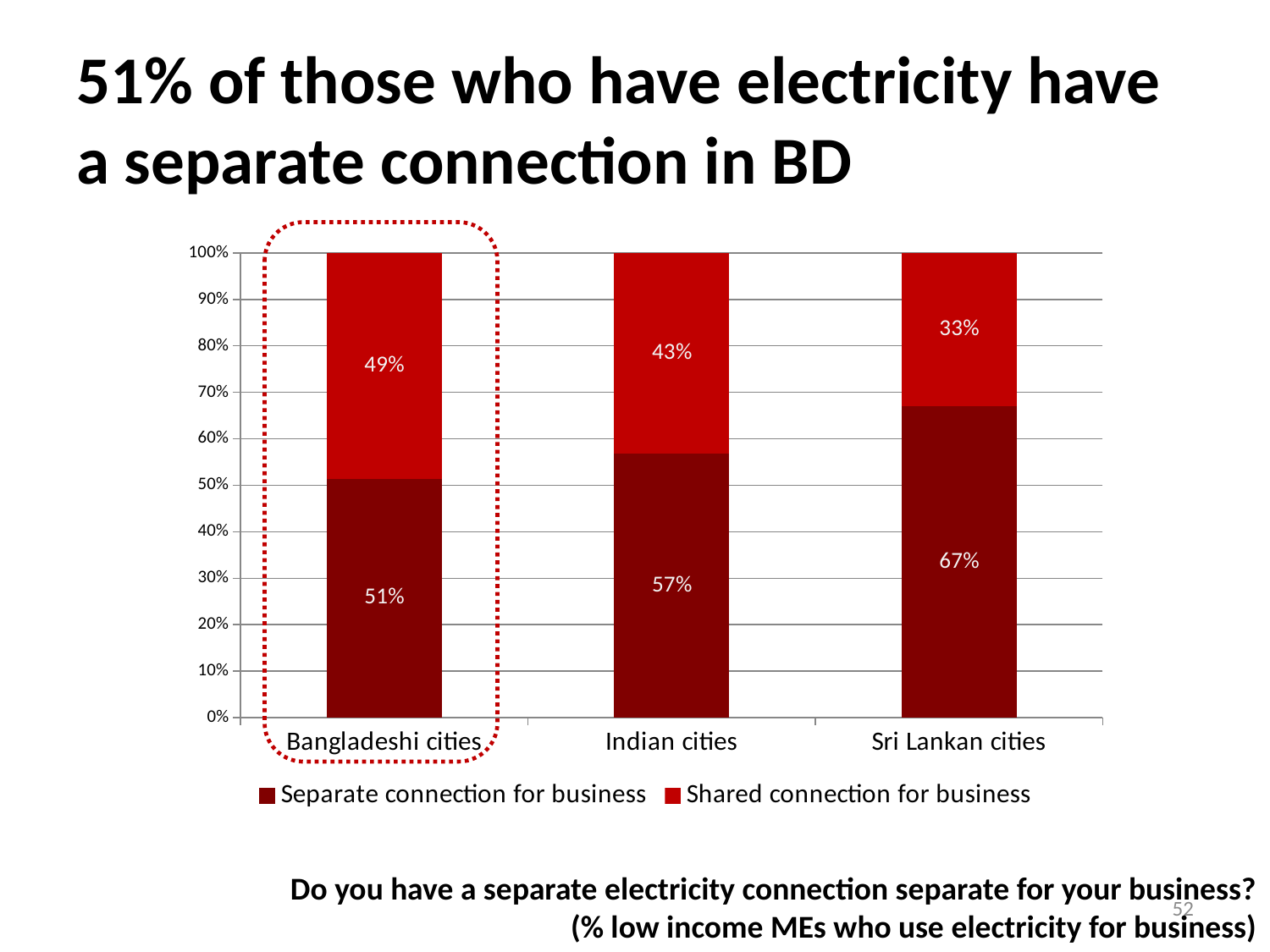
What percentage of low income MEs in Bangladeshi cities have a separate connection for business? 51% Which city group has the lowest share of separate connections for business? Bangladeshi cities What percentage of low income MEs in Indian cities have a shared connection for business? 43% Which series is shown in the darker red colour? Separate connection for business How many city groups are shown on the x axis? 3 What kind of chart is shown on the slide? Stacked bar chart Which city group has the highest share of separate connections for business? Sri Lankan cities What percentage of low income MEs in Sri Lankan cities have a shared connection for business? 33% Which is larger: the shared connection share in Bangladeshi cities or in Indian cities? Bangladeshi cities How many series does the legend list? 2 What percentage of low income MEs in Sri Lankan cities have a separate connection for business? 67% What is the difference in percentage points between the separate connection share in Sri Lankan cities and in Bangladeshi cities? 16